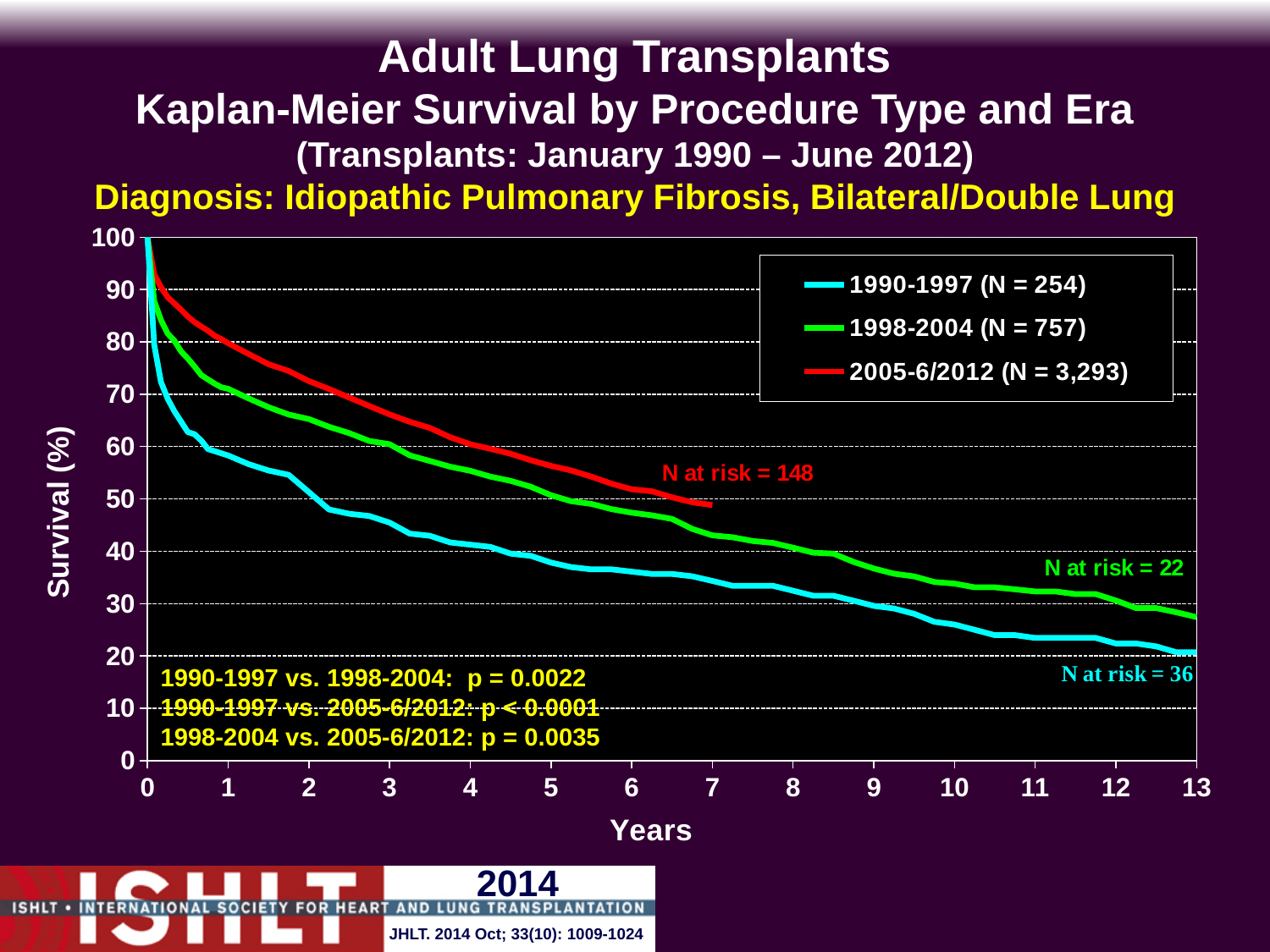
What is the N at risk printed for the 2005-6/2012 curve? 148 At 5 years, which era has the highest survival? 2005-6/2012 Do the survival curves rise or fall as years increase? fall What is the N for the 1998-2004 era shown in the legend? 757 Is the survival for the 1998-2004 era at 13 years greater or less than 30? less What kind of chart is shown on the slide? Line chart What is the N for the 2005-6/2012 era shown in the legend? 3,293 Is the survival for the 2005-6/2012 era at 5 years greater or less than 50? greater What is the N at risk printed for the 1990-1997 curve? 36 How many series does the legend list? 3 At 10 years, which era has the lowest survival? 1990-1997